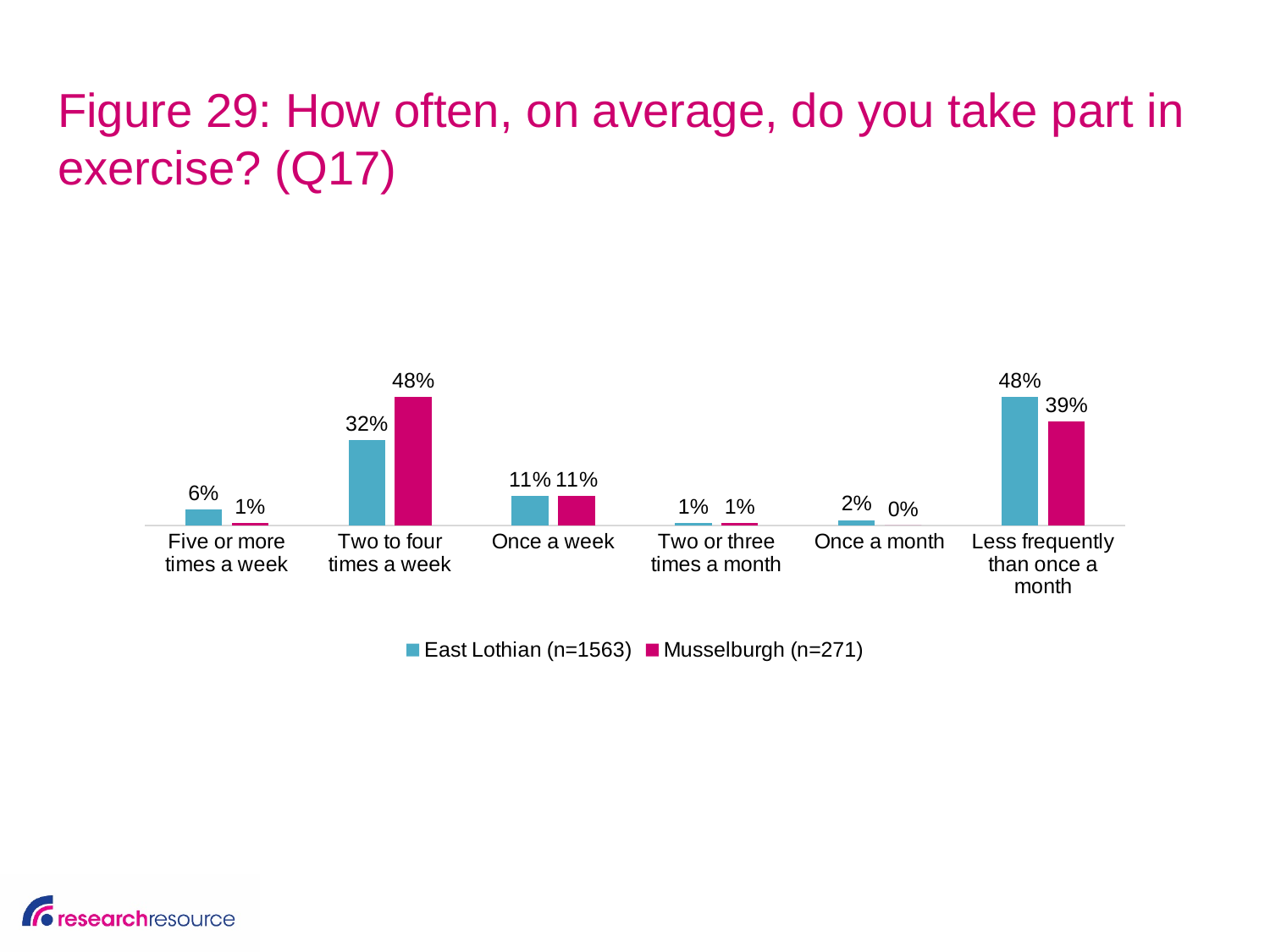
What percentage of Musselburgh respondents take part in exercise two to four times a week? 48% What is the value for East Lothian in the 'Less frequently than once a month' category? 48% What is the difference between the East Lothian and Musselburgh values for 'Less frequently than once a month'? 9 percentage points Which category has the lowest value for Musselburgh? Once a month For 'Two to four times a week', which is larger: the East Lothian value or the Musselburgh value? Musselburgh What is the sample size (n) for the Musselburgh series shown in the legend? 271 How many series does the legend list? 2 Which category has the highest value for Musselburgh? Two to four times a week What percentage of East Lothian respondents take part in exercise two to four times a week? 32% How many categories are shown on the x axis? 6 What is the value for Musselburgh in the 'Five or more times a week' category? 1% What kind of chart is shown on the slide? Bar chart